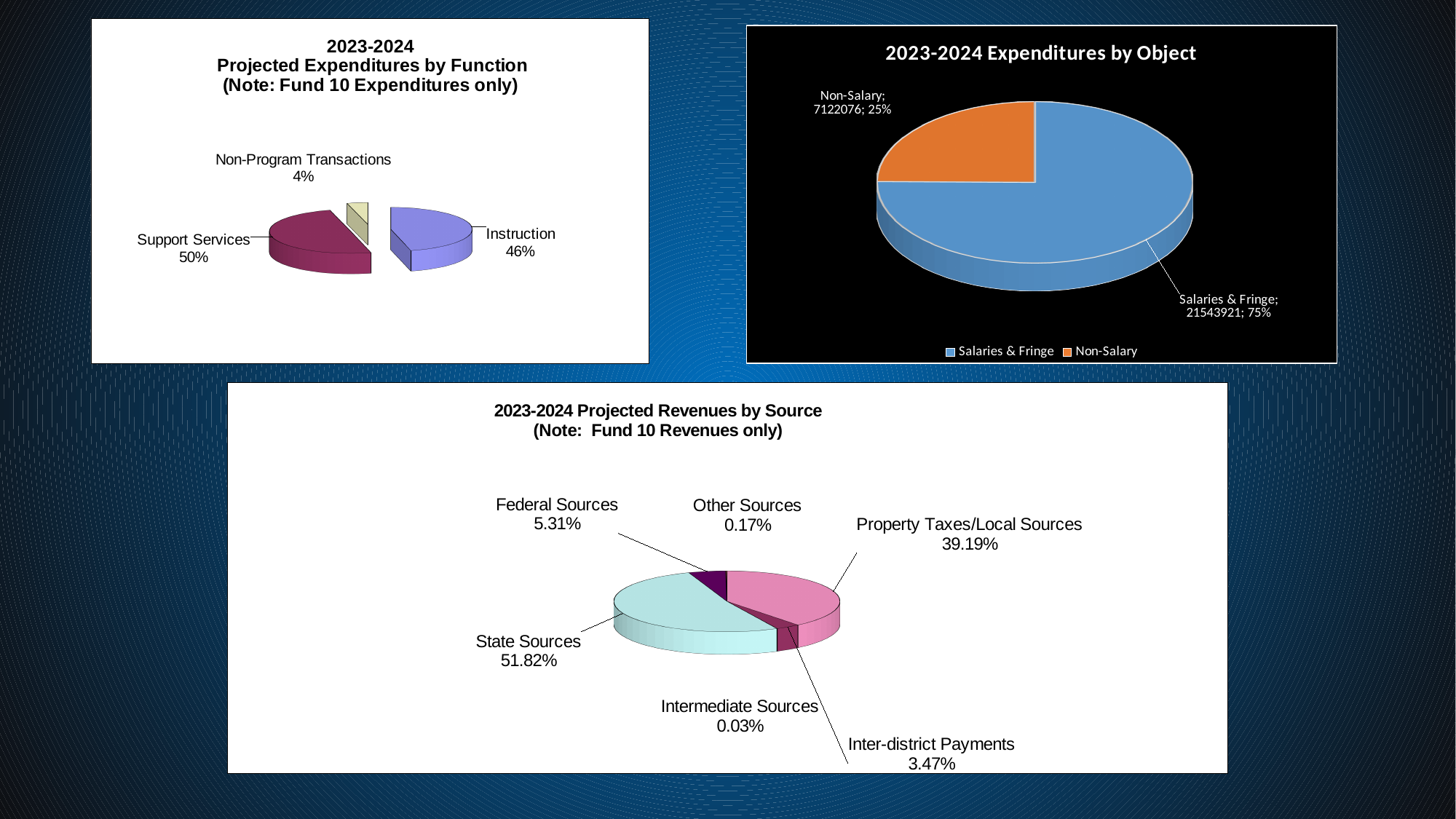
In the '2023-2024 Projected Expenditures by Function' chart, which category has the largest share? Support Services In the '2023-2024 Projected Revenues by Source' chart, what share does State Sources have? 51.82% In the '2023-2024 Expenditures by Object' chart, what share does Non-Salary have? 25% In the '2023-2024 Expenditures by Object' chart, what is the value for Non-Salary? 7122076 In the '2023-2024 Expenditures by Object' chart, what is the value for Salaries & Fringe? 21543921 In the '2023-2024 Projected Expenditures by Function' chart, how many categories are shown? 3 In the '2023-2024 Projected Expenditures by Function' chart, what share does Support Services have? 50% What kind of chart is the '2023-2024 Projected Revenues by Source' chart? Pie chart In the '2023-2024 Projected Revenues by Source' chart, which category has the smallest share? Intermediate Sources In the '2023-2024 Expenditures by Object' chart, how many entries does the legend list? 2 In the '2023-2024 Projected Revenues by Source' chart, which is larger, Federal Sources or Inter-district Payments? Federal Sources